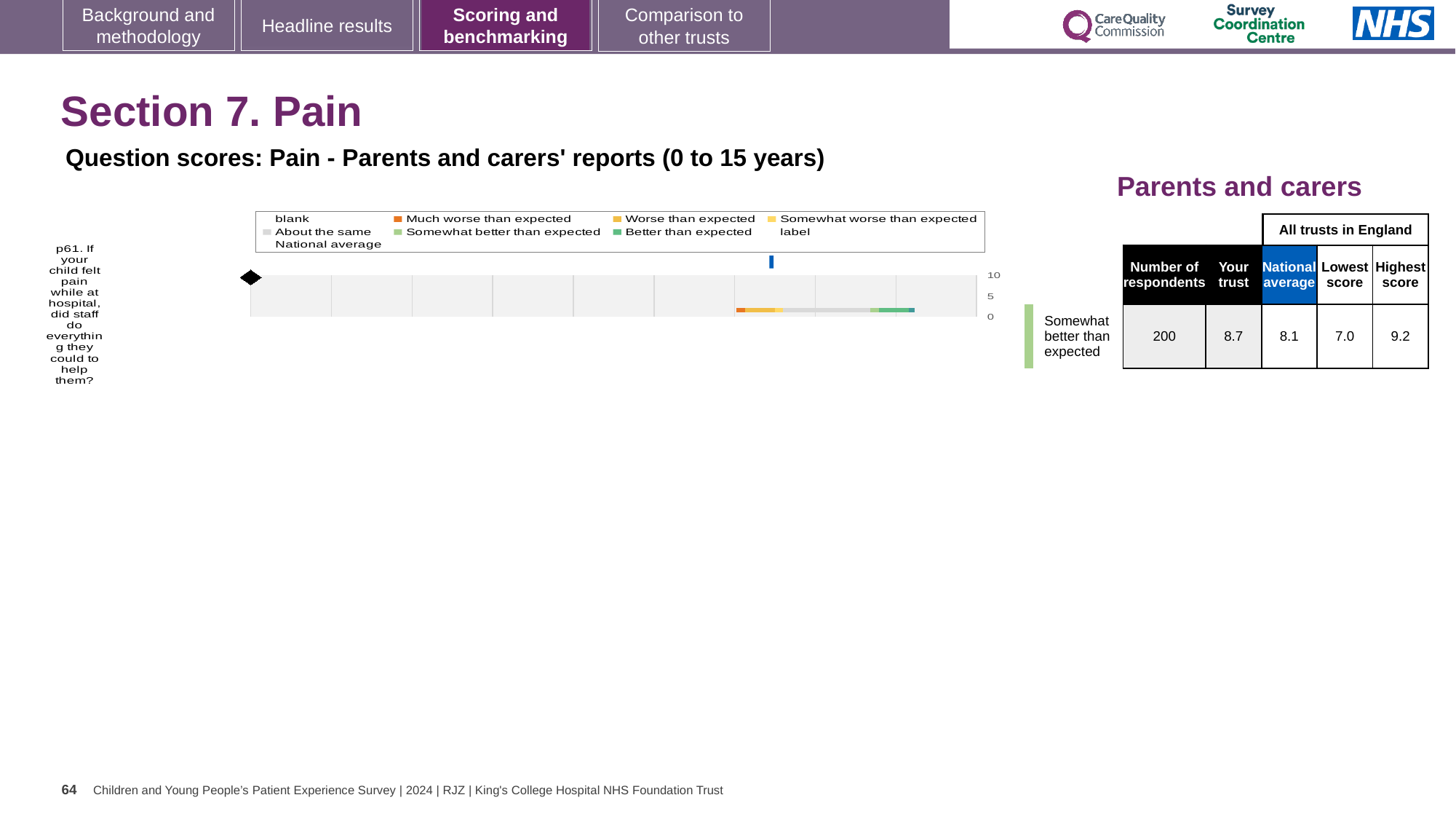
In the table on the right, what is the National average score for question p61? 8.1 According to the table, which is larger for question p61: the 'Your trust' score or the National average? Your trust In the table on the right, what is the 'Your trust' score for question p61? 8.7 What kind of chart is shown on the slide for question p61? bar chart According to the table, what is the difference between the Highest score and the Lowest score for question p61? 2.2 How many survey questions are plotted in the chart? 1 What benchmark category is given for question p61 next to the table? Somewhat better than expected What is the highest tick value shown on the chart's axis? 10 In the table on the right, how many respondents answered question p61? 200 Which legend entry is shown in orange in the chart's legend? Much worse than expected In the table on the right, what is the Highest score among all trusts in England for question p61? 9.2 In the table on the right, what is the Lowest score among all trusts in England for question p61? 7.0